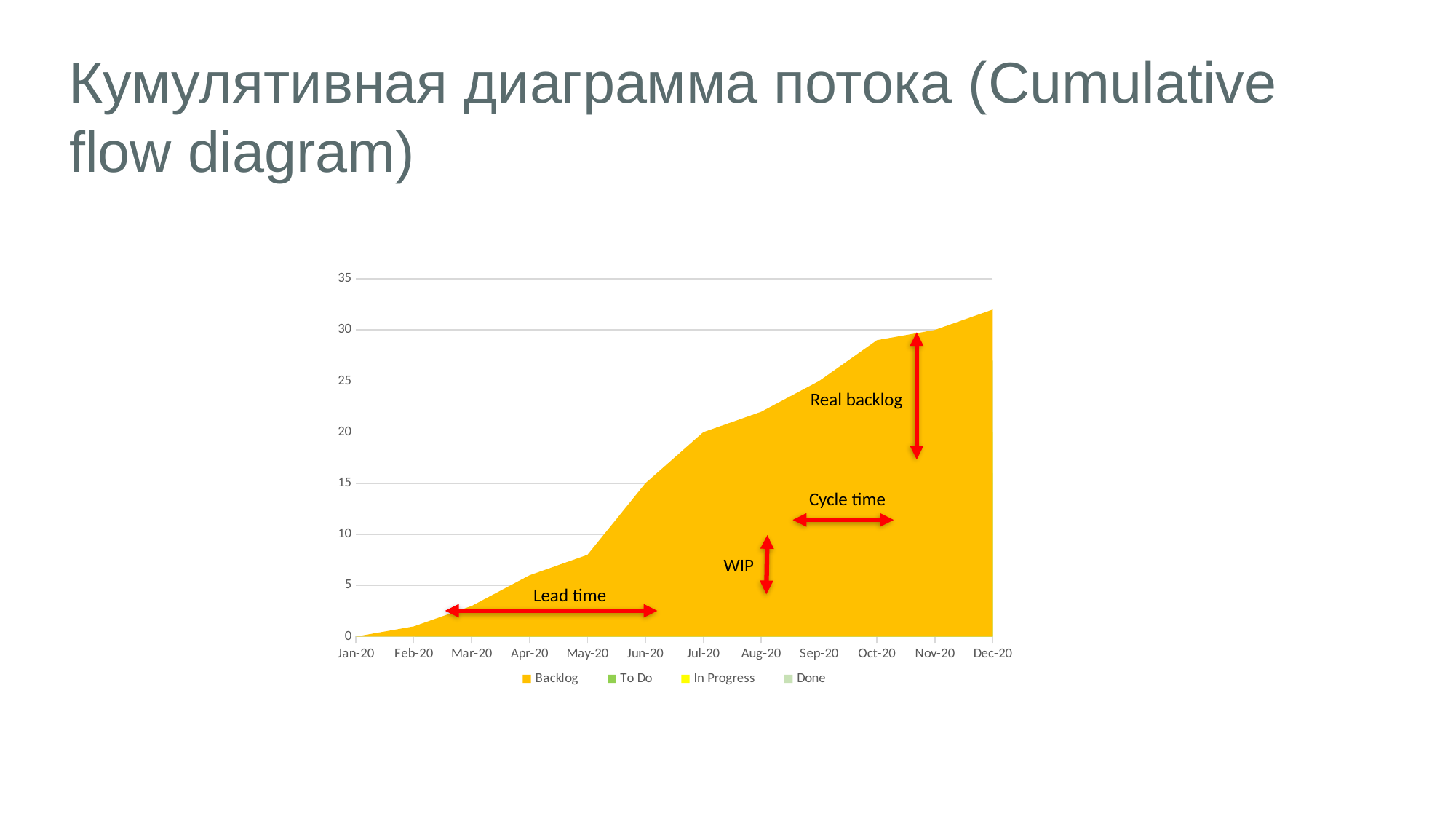
Which month has the lowest Backlog value? Jan-20 Which month has the highest Backlog value? Dec-20 How many series does the legend list? 4 Does the Backlog value rise or fall from Jan-20 to Dec-20? rise How many months are plotted along the x axis? 12 Which is larger, the Backlog value for Oct-20 or for Jun-20? Oct-20 Which series is listed first in the legend? Backlog What kind of chart is shown on the slide? area chart Is the Backlog value for Sep-20 greater or less than 30? less Is the Backlog value for May-20 greater or less than 10? less Is the Backlog value for Mar-20 greater or less than 5? less